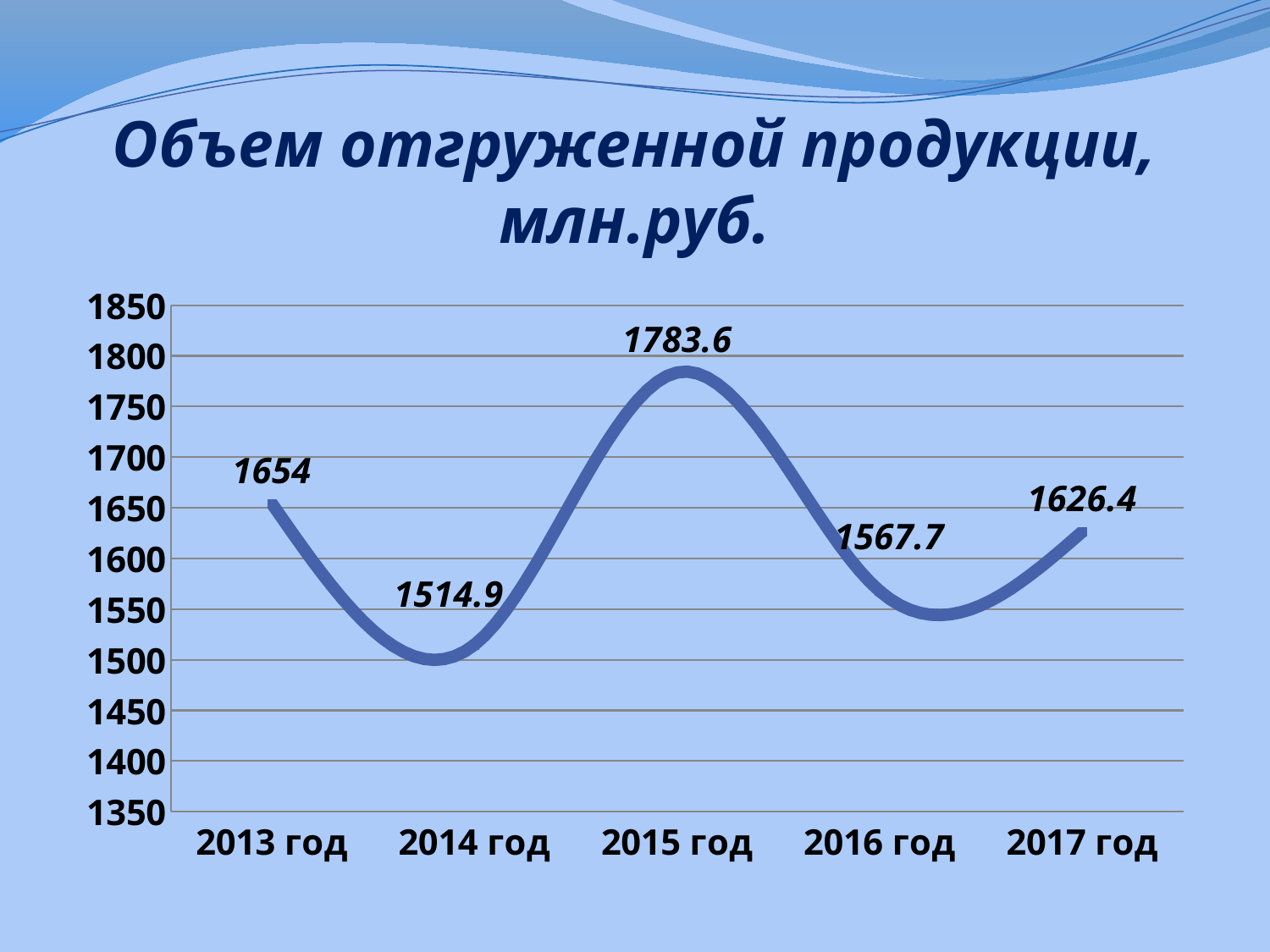
What is the value for 2016 год? 1567.7 How many years are plotted on the chart? 5 What is the title of the chart? Объем отгруженной продукции, млн.руб. Which year has the lowest value? 2014 год What is the value for 2013 год? 1654 What is the value for 2017 год? 1626.4 What is the value for 2015 год? 1783.6 Which year has the highest value? 2015 год Is the value for 2016 год greater or less than 1600? less Which is larger, the value for 2013 год or the value for 2017 год? 2013 год What kind of chart is shown on the slide? line chart What is the difference between the values for 2015 год and 2014 год? 268.7